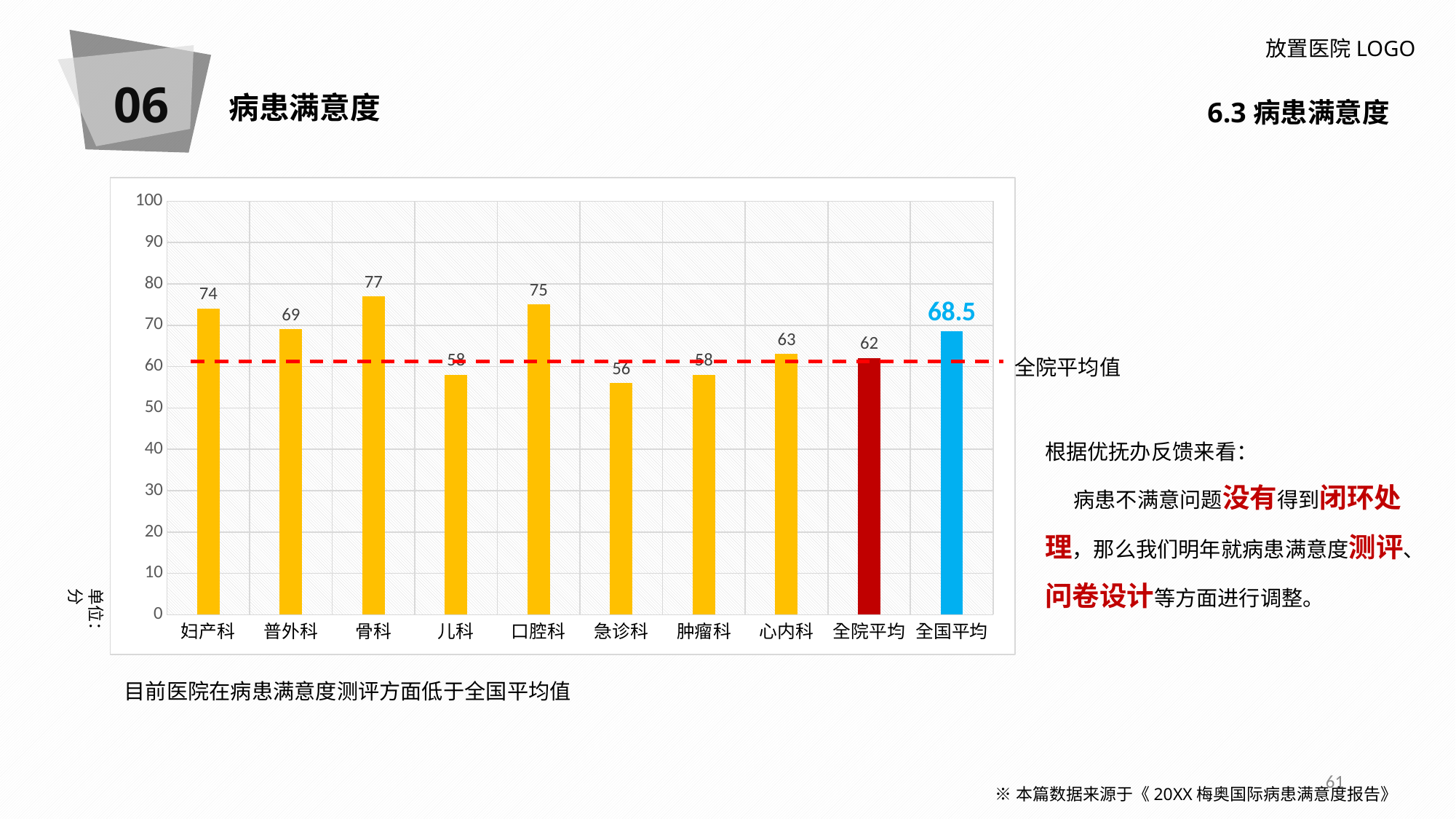
What kind of chart is shown on the slide? bar chart Is the value for 心内科 greater or less than 60? greater What is the difference between the values for 全国平均 and 全院平均? 6.5 Which is larger, the value for 妇产科 or the value for 普外科? 妇产科 What is the value for 骨科? 77 Which category has the highest value? 骨科 How many categories are shown on the x axis? 10 What does the red dashed horizontal line represent? 全院平均值 What is the difference between the values for 骨科 and 儿科? 19 What is the value for 全国平均? 68.5 What is the value for 全院平均? 62 Which category has the lowest value? 急诊科